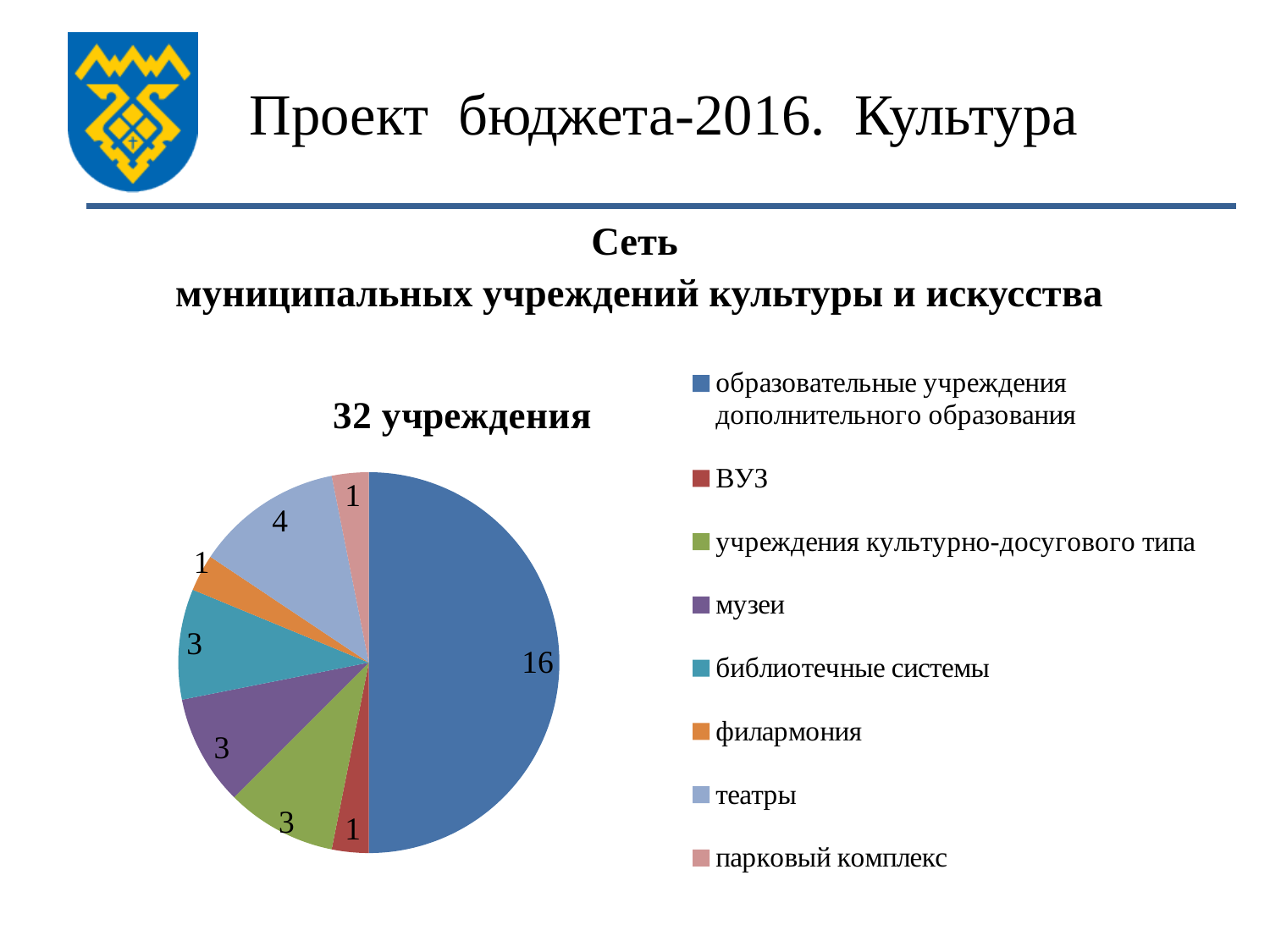
Which is larger, the value for театры or the value for музеи? театры What is the value for театры? 4 What is the difference between the values for образовательные учреждения дополнительного образования and театры? 12 What kind of chart is shown on the slide? pie chart What share of the pie does образовательные учреждения дополнительного образования represent? 50% What is the value for библиотечные системы? 3 What is the value for образовательные учреждения дополнительного образования? 16 What is the value for филармония? 1 Which category has the largest slice of the pie? образовательные учреждения дополнительного образования What is the title of the chart? 32 учреждения How many slices does the pie chart have? 8 How many entries does the legend list? 8